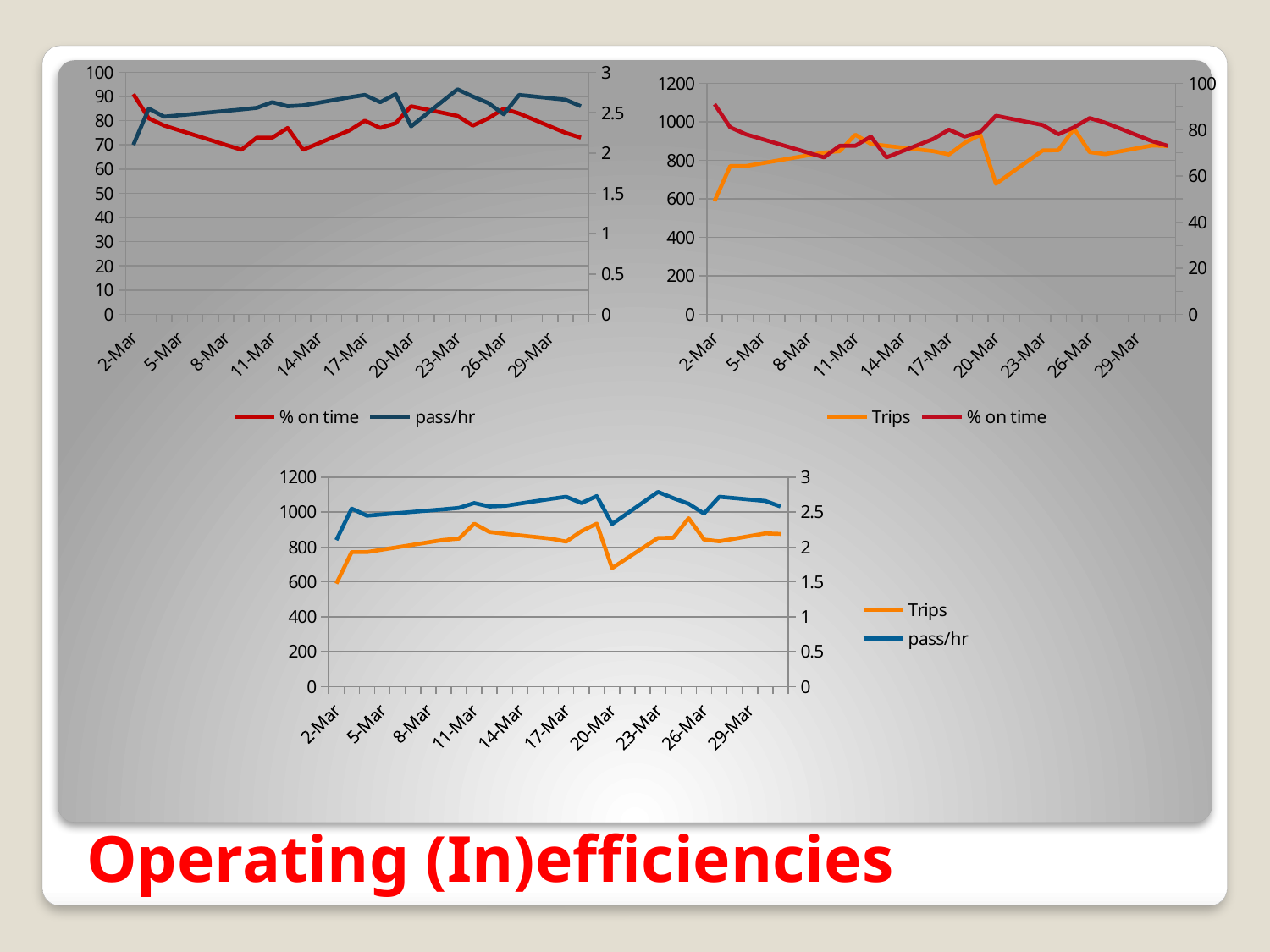
In the top-right chart, is the value of Trips on 2-Mar greater or less than 800? less In the top-left chart, is the value of pass/hr on 2-Mar greater or less than 2.5? less In the bottom chart, is the value of Trips on 11-Mar greater or less than 800? greater Which two series are listed in the legend of the bottom chart? Trips and pass/hr How many date labels are shown on the x axis of the bottom chart? 10 What kind of chart is the top-left chart on the slide? line chart How many series does the legend of the top-left chart list? 2 Which two series are listed in the legend of the top-right chart? Trips and % on time In the top-left chart, does the % on time line rise or fall from 2-Mar to 8-Mar? fall